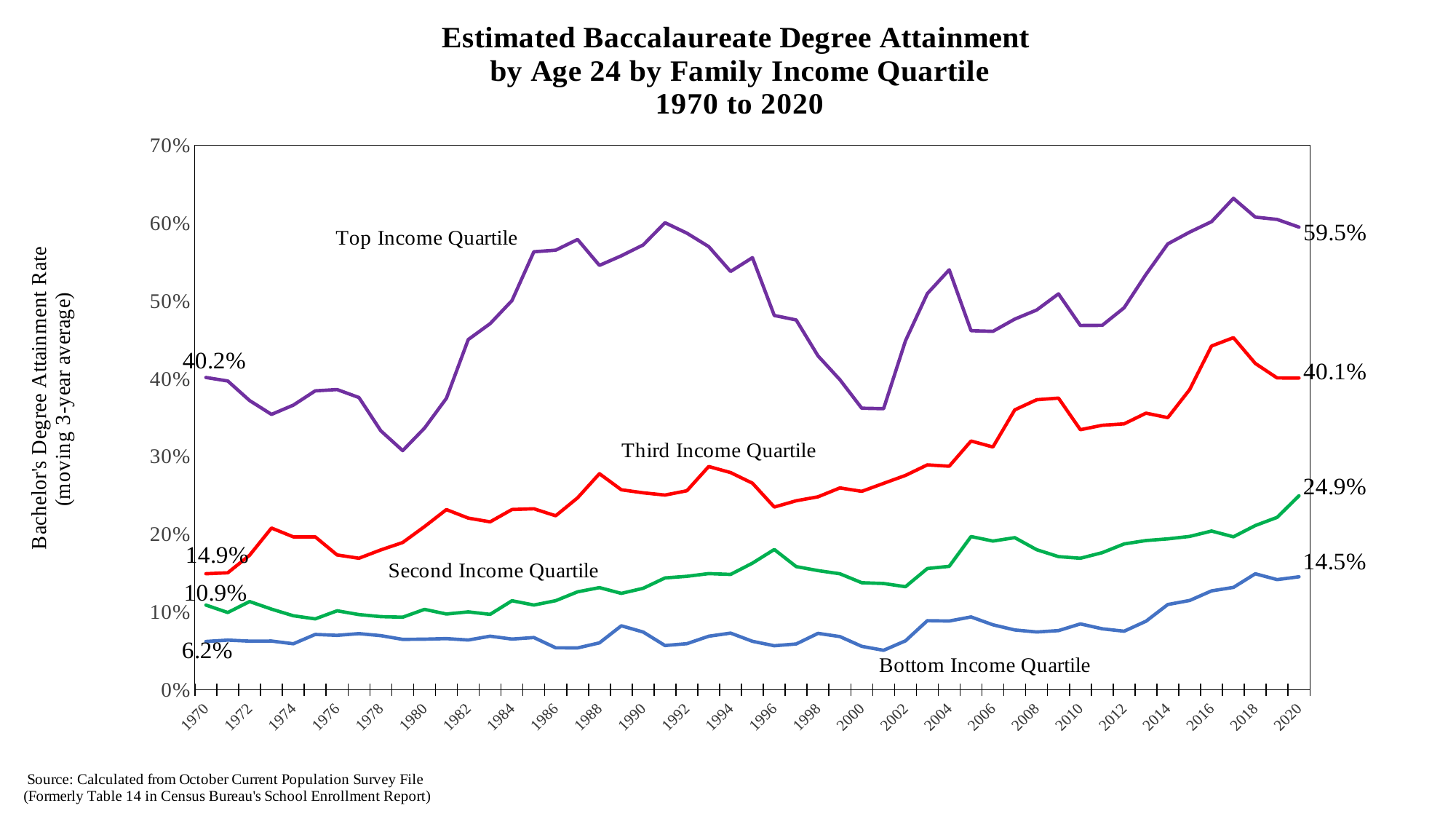
Is the value for the Top Income Quartile in 2000 greater or less than 40%? less What is the value for the Top Income Quartile in 2020? 59.5% What is the difference between the Third Income Quartile (40.1%) and the Second Income Quartile (24.9%) in 2020? 15.2 percentage points Which income quartile has the lowest attainment rate in 1970? Bottom Income Quartile What is the value for the Third Income Quartile in 2020? 40.1% What is the value for the Top Income Quartile in 1970? 40.2% What is the value for the Second Income Quartile in 2020? 24.9% What kind of chart is shown on the slide? Line chart What is the value for the Bottom Income Quartile in 1970? 6.2% How many income quartile lines are plotted on the chart? 4 By how many percentage points did the Top Income Quartile value change from 1970 (40.2%) to 2020 (59.5%)? 19.3 percentage points Which income quartile has the highest attainment rate in 2020? Top Income Quartile